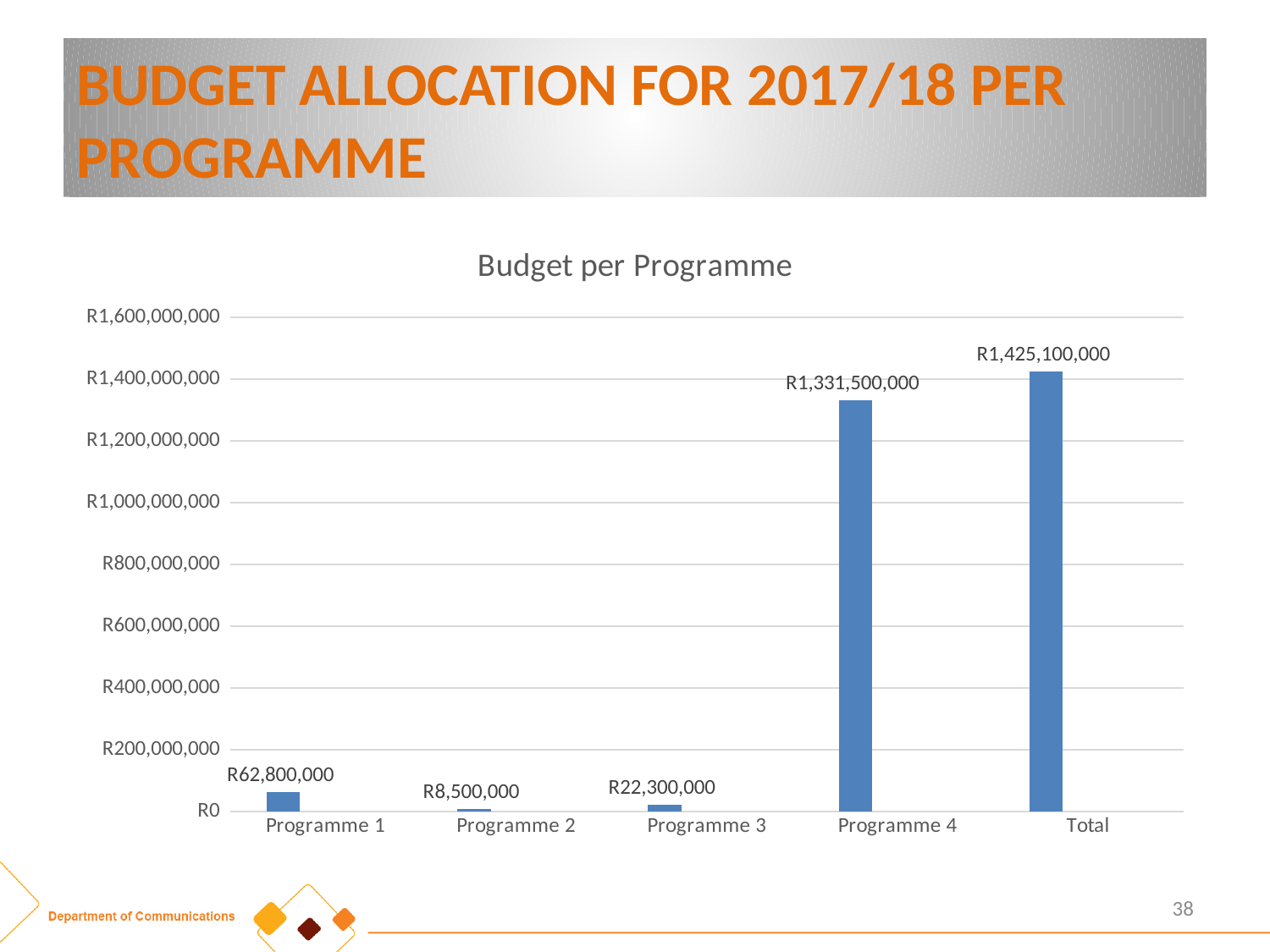
What is the budget for Programme 4? R1,331,500,000 Which has a larger budget, Programme 2 or Programme 3? Programme 3 What kind of chart is shown on the slide? Bar chart What is the highest value labelled on the vertical axis? R1,600,000,000 What value is shown for the Total bar? R1,425,100,000 Which programme has the lowest budget? Programme 2 What is the difference between the budgets of Programme 1 and Programme 3? R40,500,000 What is the title of the chart? Budget per Programme How many bars are shown in the chart? 5 Is the value for Programme 4 greater or less than R1,200,000,000? greater What is the budget for Programme 1? R62,800,000 Which of the four programmes has the highest budget? Programme 4